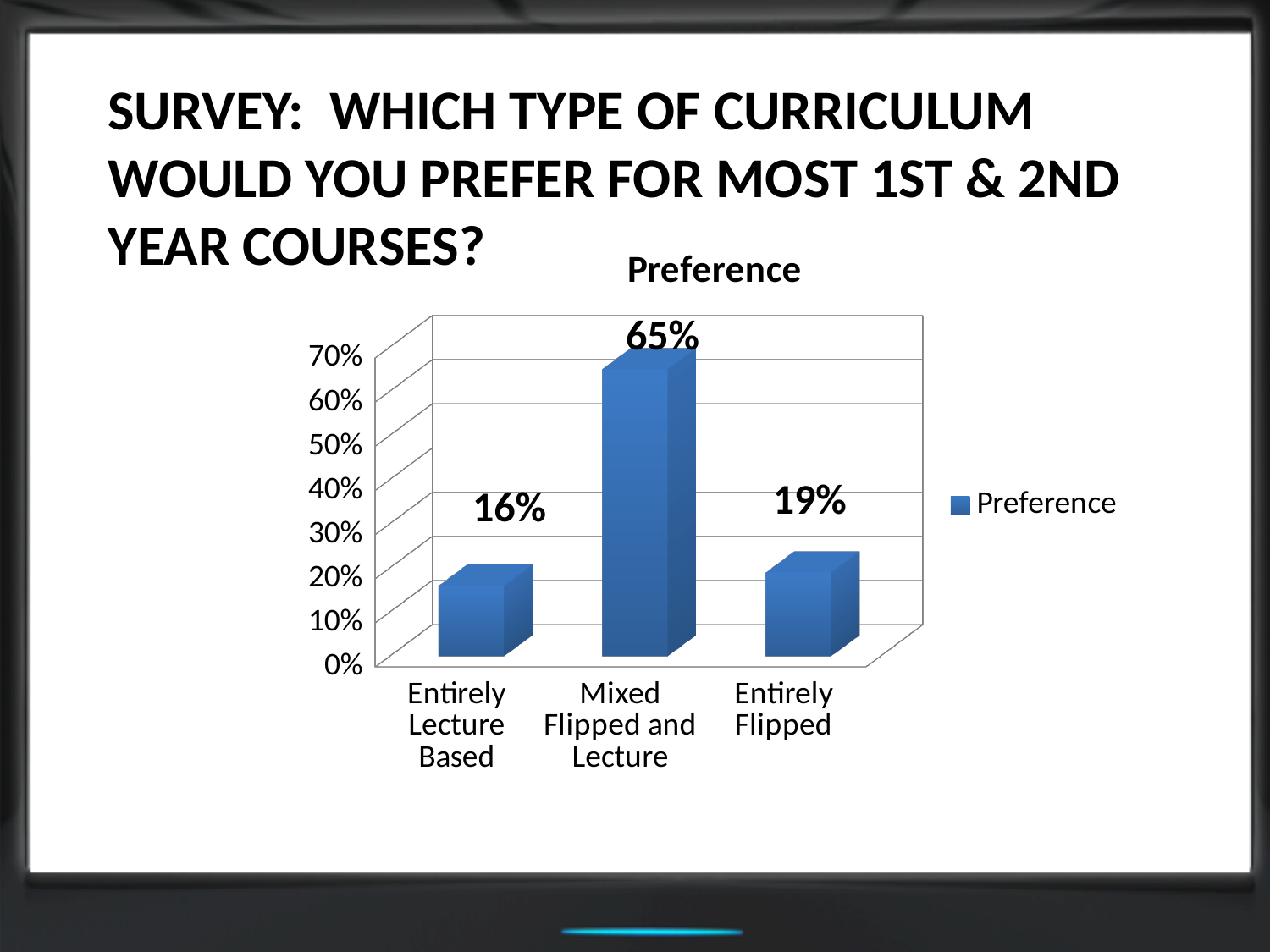
Is the value for Mixed Flipped and Lecture greater or less than 50%? greater Which category has the highest preference? Mixed Flipped and Lecture What is the value for Entirely Flipped? 19% What is the title of the chart? Preference Which category has the lowest preference? Entirely Lecture Based What is the value for Mixed Flipped and Lecture? 65% What is the value for Entirely Lecture Based? 16% How many categories are shown on the x axis? 3 Which is larger, the value for Entirely Flipped or the value for Entirely Lecture Based? Entirely Flipped What is the difference between the values for Mixed Flipped and Lecture and Entirely Flipped? 46% What is the difference between the values for Entirely Flipped and Entirely Lecture Based? 3% What type of chart is shown on the slide? bar chart